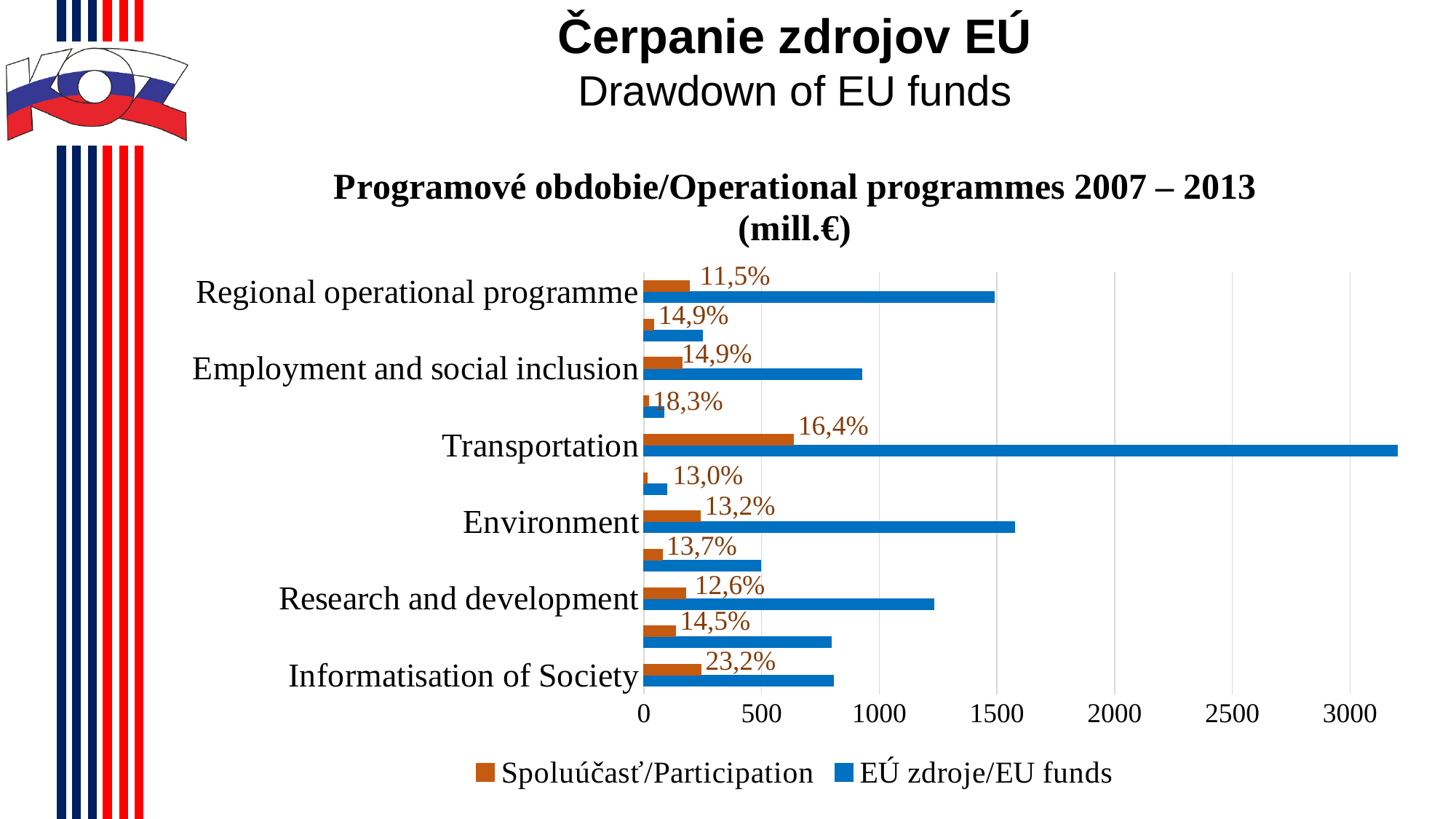
What is the title of the chart? Programové obdobie/Operational programmes 2007 – 2013 (mill.€) How many series does the legend list? 2 Which programme has the highest EU funds value? Transportation Is the EU funds value for Informatisation of Society greater or less than 1000? less What percentage label is printed on the Participation bar for Informatisation of Society? 23,2% What are the two series named in the legend? Spoluúčasť/Participation and EÚ zdroje/EU funds What percentage label is printed on the Participation bar for Research and development? 12,6% What kind of chart is shown on the slide? bar chart Which is larger, the EU funds value for Environment or for Research and development? Environment What percentage label is printed on the Participation bar for Transportation? 16,4% What percentage label is printed on the Participation bar for Regional operational programme? 11,5% Is the EU funds value for Transportation greater or less than 3000? greater